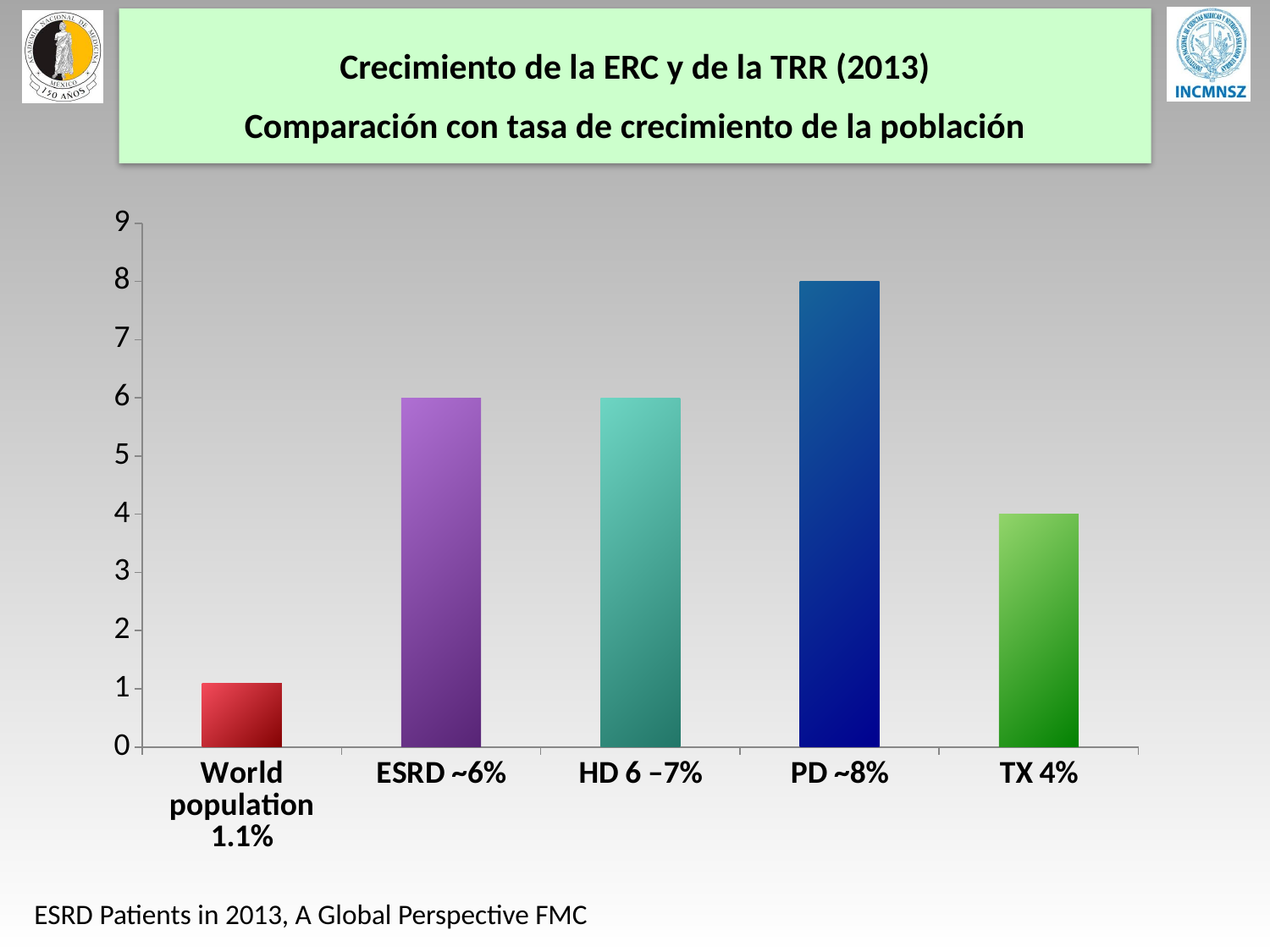
What value does the bar for ESRD ~6% reach on the y axis? 6 Which category has the highest bar in the chart? PD ~8% What is the difference between the bar values for PD ~8% and ESRD ~6%? 2 What value does the bar for TX 4% reach on the y axis? 4 What type of chart is shown on the slide? bar chart What is the first line of the slide title above the chart? Crecimiento de la ERC y de la TRR (2013) Which category has the lowest bar in the chart? World population 1.1% How many categories are shown on the x axis of the chart? 5 Which bar is taller, PD ~8% or TX 4%? PD ~8% What is the difference between the bar values for PD ~8% and TX 4%? 4 What value does the bar for PD ~8% reach on the y axis? 8 Is the value for World population 1.1% greater or less than 2? less